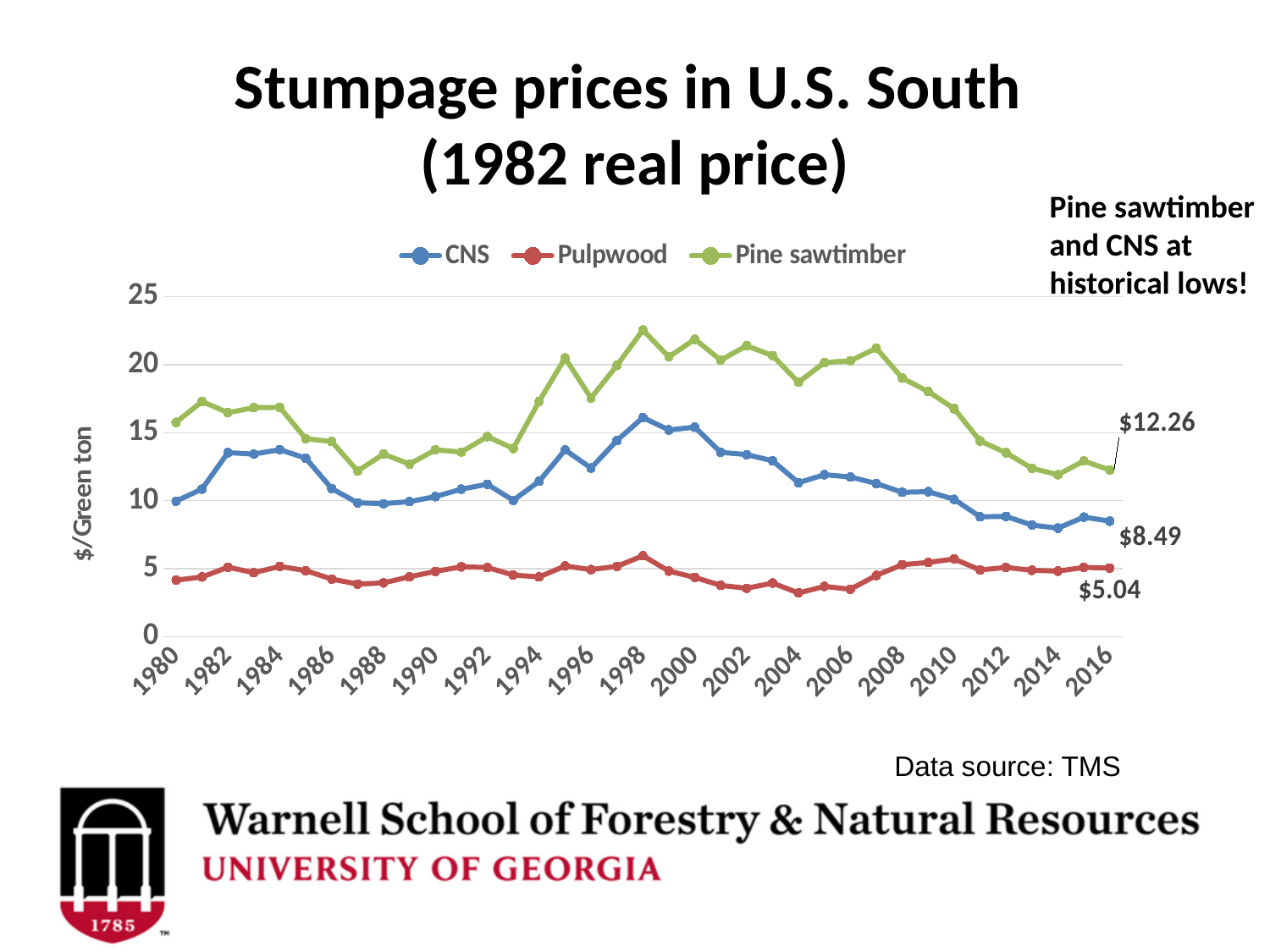
Is the Pulpwood value for 2004 greater or less than 5? less Which series has the lowest prices across the whole period? Pulpwood Which series has the highest price in 2016? Pine sawtimber What is the label on the vertical axis? $/Green ton What is the CNS price in 2016? $8.49 What is the Pulpwood price in 2016? $5.04 Is the Pine sawtimber value for 1998 greater or less than 20? greater How many series does the legend list? 3 What kind of chart is shown on the slide? line chart What is the Pine sawtimber price in 2016? $12.26 Does the CNS price rise or fall from 2008 to 2016? fall What is the difference between the Pine sawtimber and CNS prices in 2016? $3.77